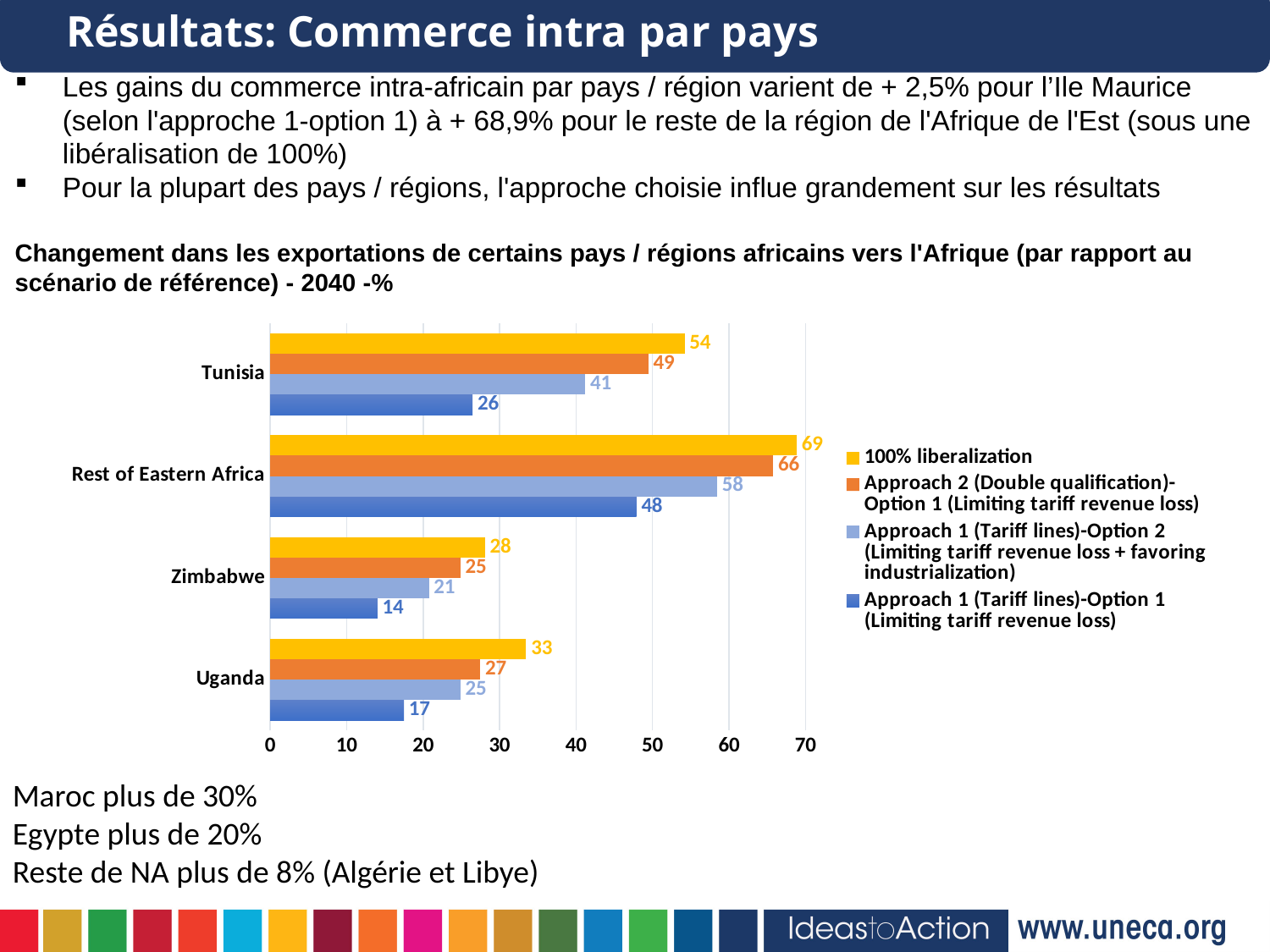
Which category has the lowest value under Approach 1 (Tariff lines)-Option 1? Zimbabwe What is the value for Zimbabwe under Approach 2 (Double qualification)-Option 1? 25 What is the difference between the Approach 2 value and the Approach 1-Option 2 value for Tunisia? 8 What is the difference between the 100% liberalization value and the Approach 1 (Tariff lines)-Option 1 value for Rest of Eastern Africa? 21 What is the value for Uganda under Approach 1 (Tariff lines)-Option 1 (Limiting tariff revenue loss)? 17 Which category has the highest value under 100% liberalization? Rest of Eastern Africa Which series is shown in yellow in the legend? 100% liberalization Which is larger: the Approach 1 (Tariff lines)-Option 2 value for Tunisia or for Uganda? Tunisia How many categories (countries/regions) are shown on the chart? 4 What kind of chart is shown on the slide? Bar chart What is the value for Tunisia under 100% liberalization? 54 How many series does the legend list? 4